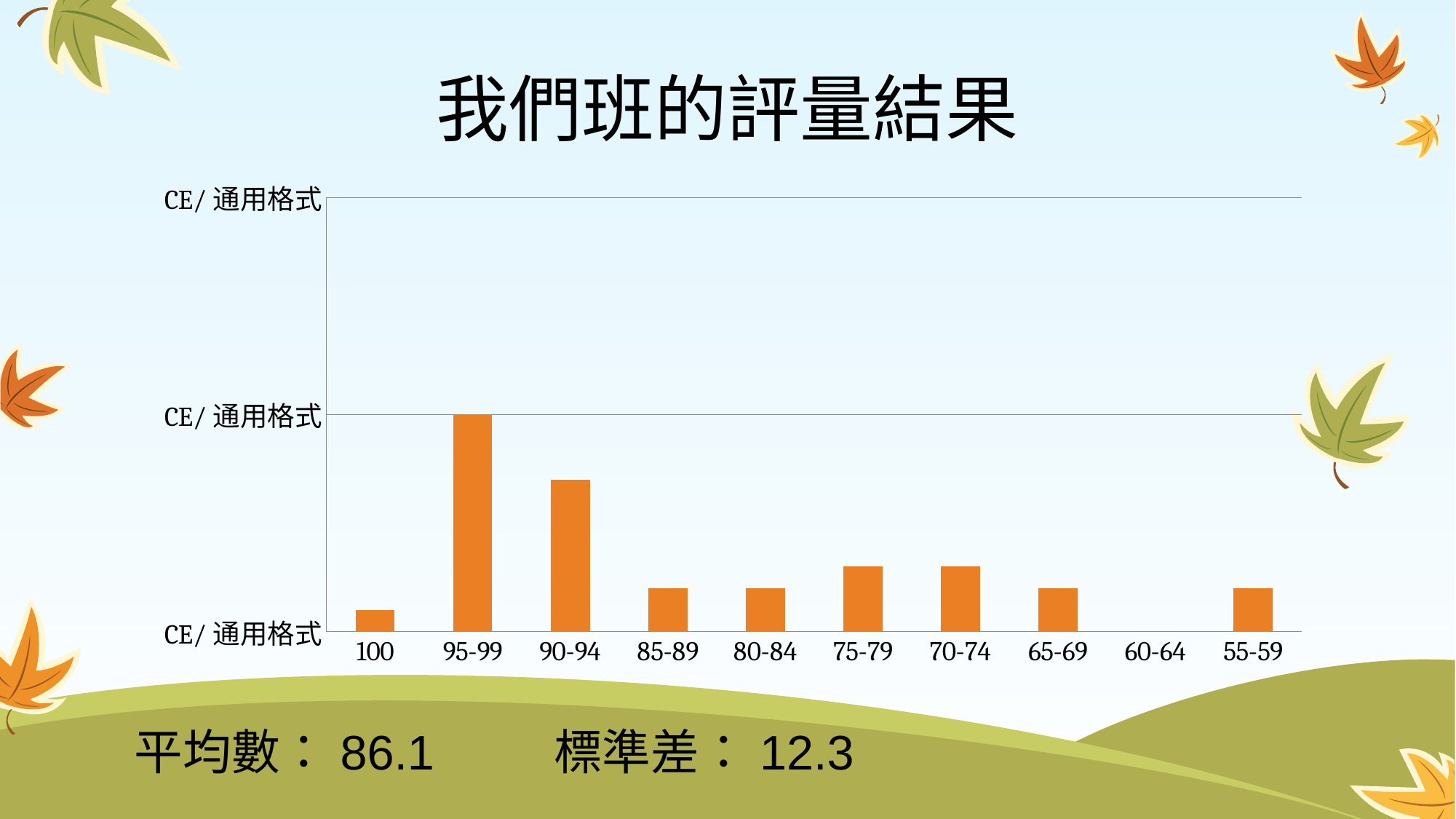
What is the title of the slide containing the chart? 我們班的評量結果 Which score category has the tallest bar in the chart? 95-99 Which bar is taller, 75-79 or 65-69? 75-79 Which bar is taller, 90-94 or 55-59? 90-94 Which bar is taller, 95-99 or 90-94? 95-99 What kind of chart is shown on the slide? bar chart How many score categories are shown on the x axis of the chart? 10 Which score category has the second tallest bar in the chart? 90-94 Which score category on the x axis has no visible bar? 60-64